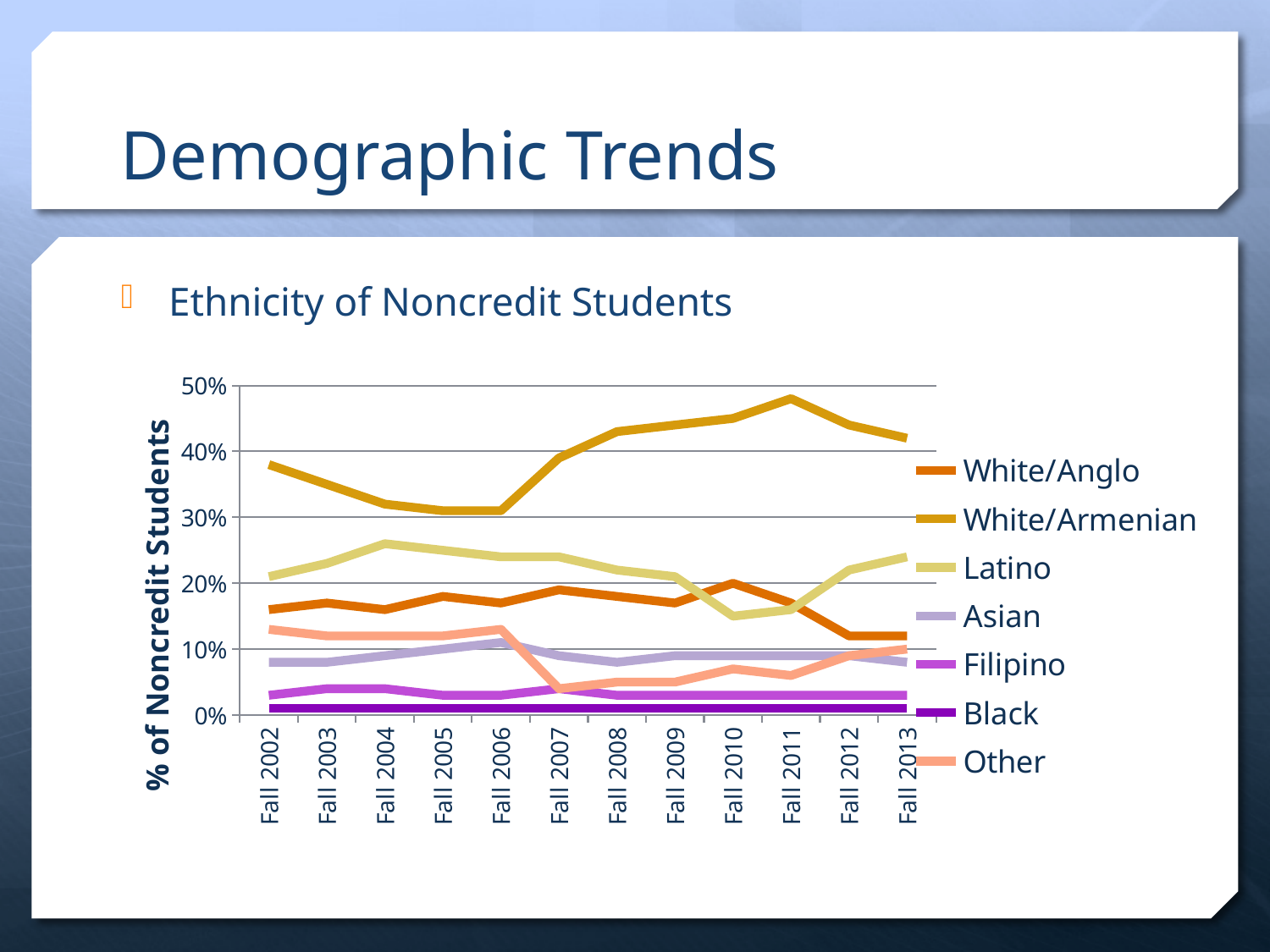
Is the value for White/Armenian in Fall 2011 greater or less than 40%? greater What kind of chart is shown on the slide? line chart Which ethnicity has the highest share of noncredit students in Fall 2013? White/Armenian How many time points (Fall terms) are shown on the x axis? 12 Does the White/Armenian line rise or fall from Fall 2006 to Fall 2011? rise Is the value for White/Anglo in Fall 2002 greater or less than 20%? less Which ethnicity has the lowest share of noncredit students across the chart? Black Is the value for Other in Fall 2007 greater or less than 10%? less How many series does the legend list? 7 In Fall 2013, which is larger: the Latino share or the White/Anglo share? Latino What is the title of the y axis? % of Noncredit Students